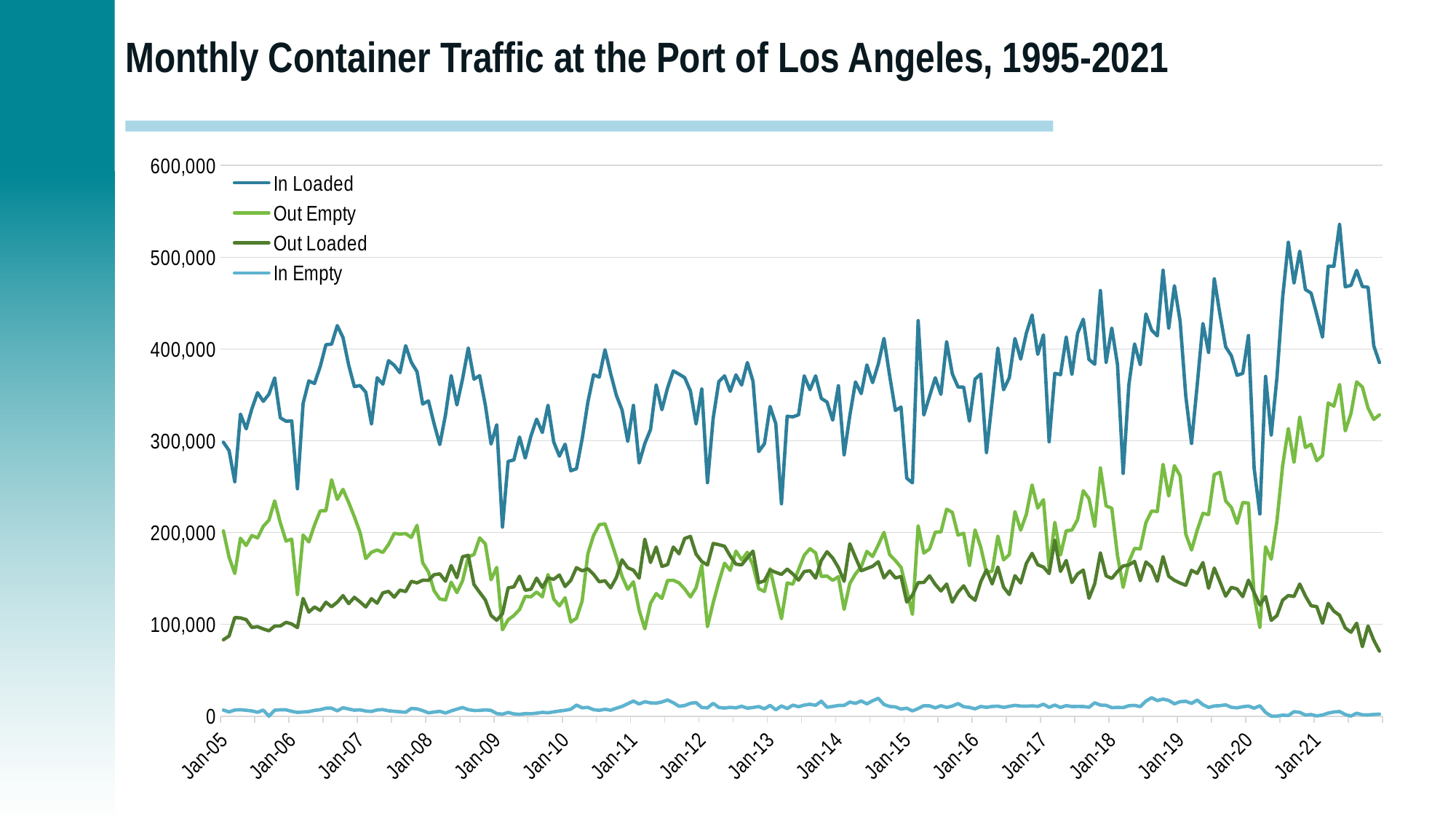
Is the value for Out Empty at Jan-05 greater or less than 300,000? less What is the title of the chart? Monthly Container Traffic at the Port of Los Angeles, 1995-2021 Which series has the lowest values across the whole period? In Empty Is the highest peak of the In Loaded series greater or less than 500,000? greater Is the value for In Loaded at Jan-05 greater or less than 400,000? less Which series has the highest values across the whole period? In Loaded At the end of the series, which is larger: Out Empty or Out Loaded? Out Empty How many series does the legend list? 4 What kind of chart is shown on the slide? line chart Does the In Loaded series generally rise or fall from Jan-05 to Jan-21? rise Does the Out Loaded series rise or fall from Jan-19 to the end of the series? fall